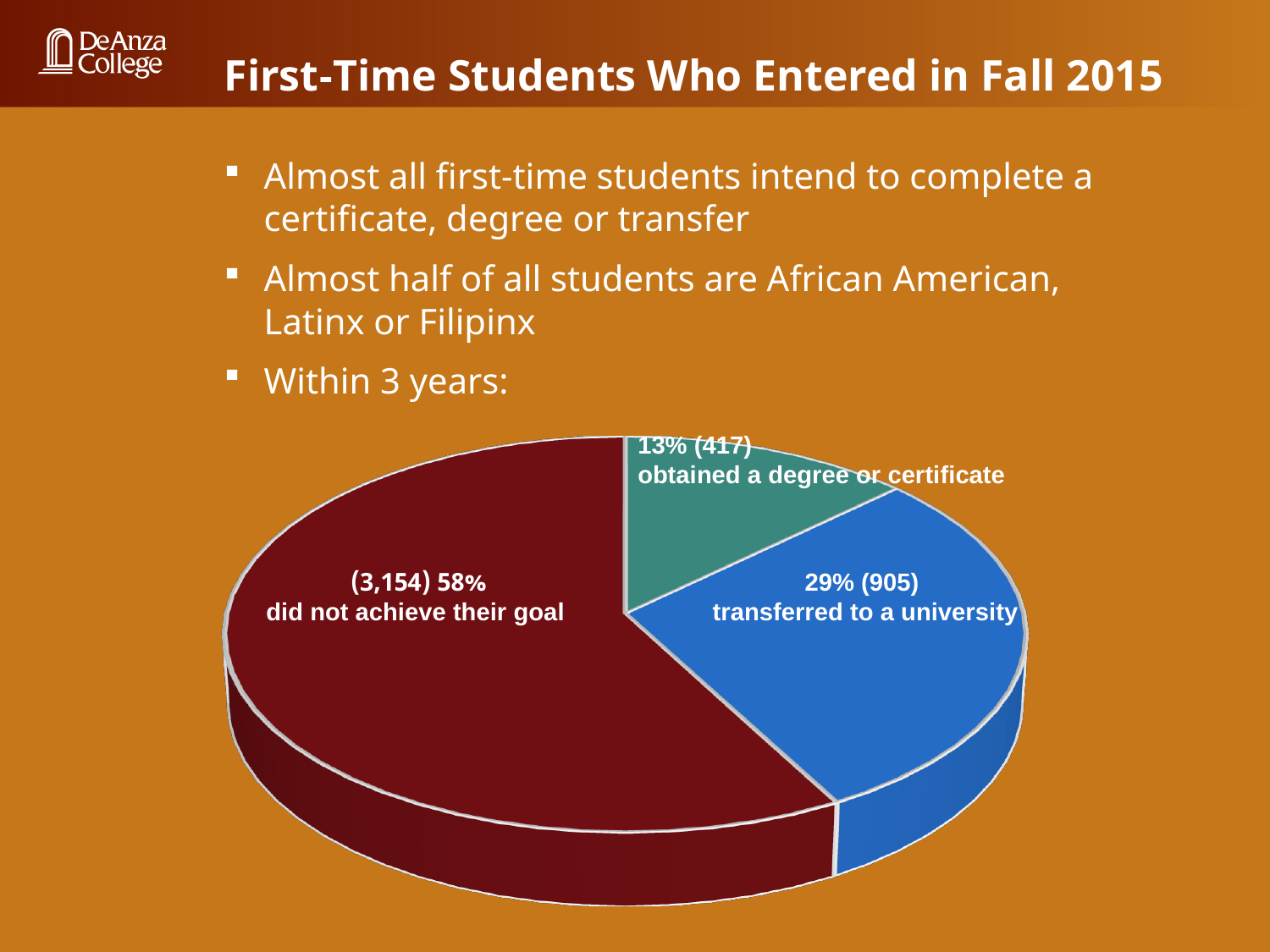
What is the difference in percentage points between students who transferred to a university and those who obtained a degree or certificate? 16 What share of the pie is taken by students who transferred to a university? 29% What percentage of students obtained a degree or certificate? 13% How many students did not achieve their goal? 3,154 What percentage of students did not achieve their goal within 3 years? 58% Which is larger: the number of students who transferred to a university or the number who obtained a degree or certificate? transferred to a university What kind of chart is shown on the slide? pie chart What colour is the slice for students who did not achieve their goal? dark red How many slices does the pie chart have? 3 Which outcome has the largest share of the pie? did not achieve their goal How many students transferred to a university? 905 Which outcome has the smallest share of the pie? obtained a degree or certificate